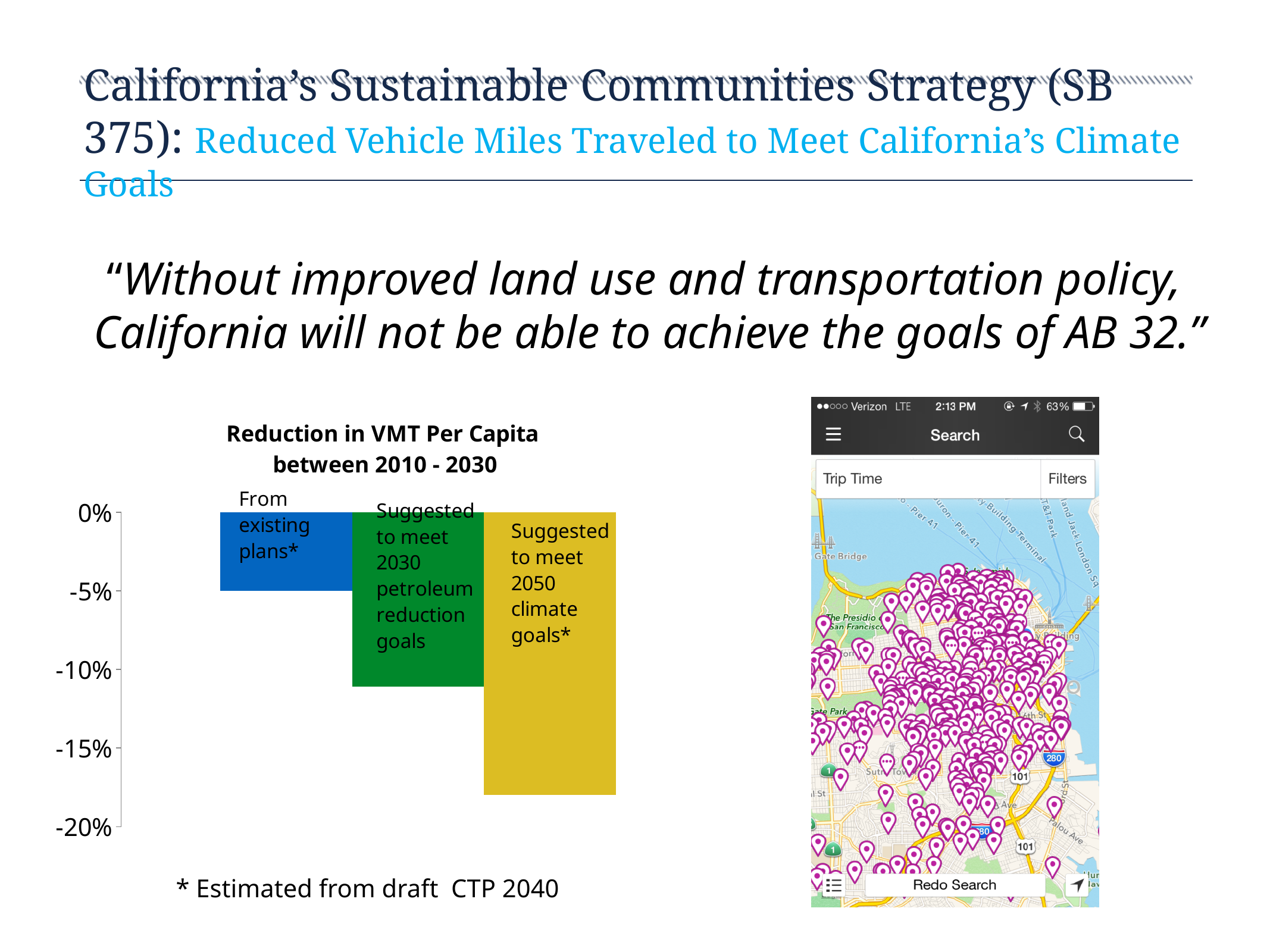
Do the bars show increasingly larger reductions from left to right? yes What is the lowest value shown on the chart's vertical axis? -20% How many bars does the chart show? 3 Is the value for 'Suggested to meet 2050 climate goals*' greater or less than -15%? less What kind of chart is shown on the slide? bar chart Which bar shows the smallest reduction in VMT per capita? From existing plans* Which shows a larger reduction: 'From existing plans*' or 'Suggested to meet 2030 petroleum reduction goals'? Suggested to meet 2030 petroleum reduction goals What colour is the bar for 'Suggested to meet 2050 climate goals*'? yellow Is the value for 'From existing plans*' greater or less than -10%? greater Is the value for 'Suggested to meet 2030 petroleum reduction goals' greater or less than -10%? less Which bar shows the largest reduction in VMT per capita? Suggested to meet 2050 climate goals* What is the title of the chart on the slide? Reduction in VMT Per Capita between 2010 - 2030